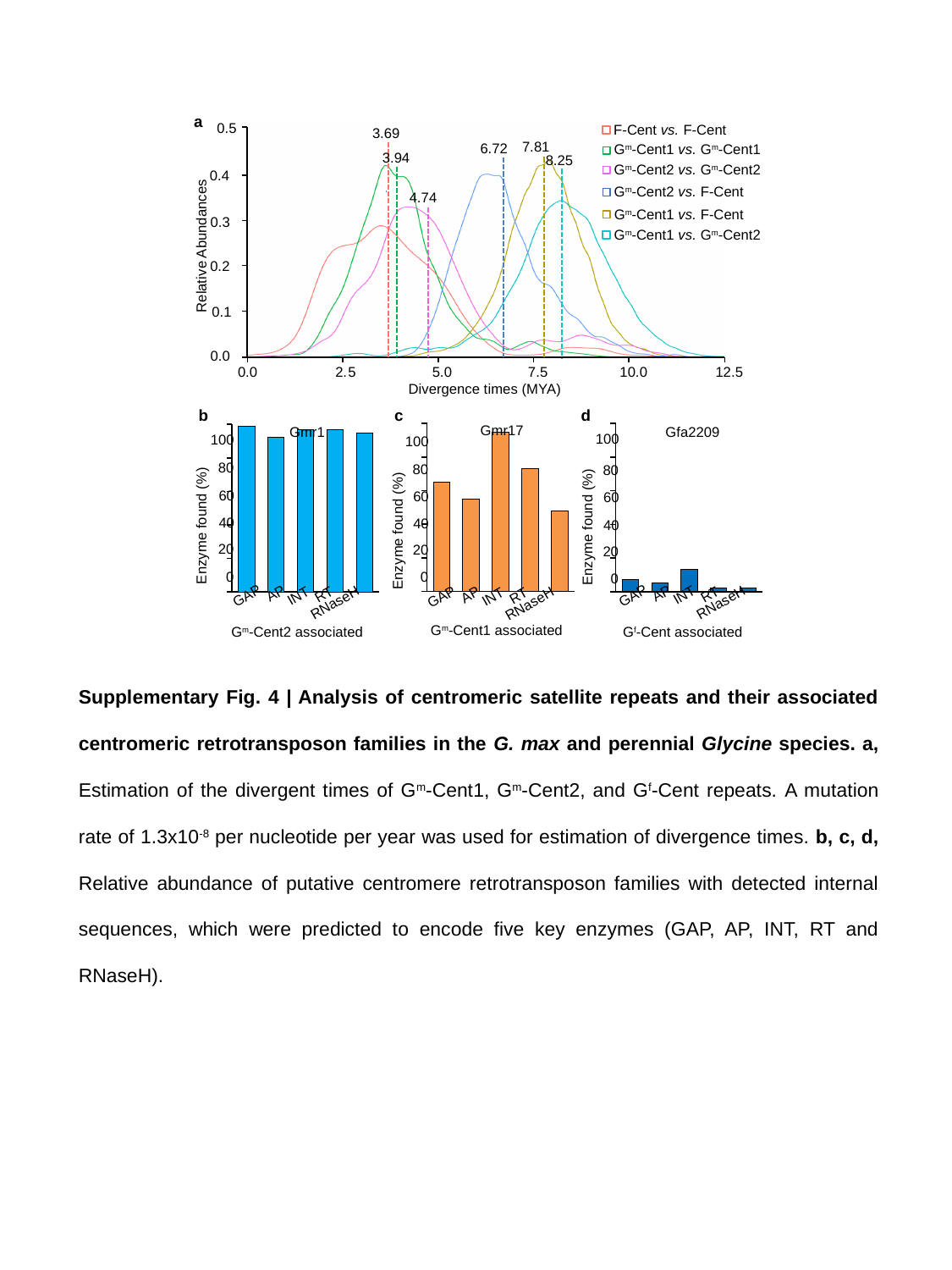
In panel a, what divergence time is labelled on the dashed line for the Gm-Cent1 vs. Gm-Cent2 comparison (the rightmost dashed line)? 8.25 In panel a, what is the smallest divergence time labelled on a dashed line? 3.69 In panel a, how many series does the legend list? 6 In panel c (Gmr17), is the value for GAP greater or less than 60? greater In panel a, what is the x-axis title? Divergence times (MYA) In panel b (Gmr1), is the value for AP greater or less than 80? greater In panel d (Gfa2209), is the value for INT greater or less than 20? less In panel b (Gmr1), how many enzyme categories are shown on the x axis? 5 In panel c (Gmr17), which enzyme has the lowest percentage found? RNaseH In panel a, what kind of chart is shown? line chart In panel c (Gmr17), what kind of chart is shown? bar chart In panel c (Gmr17), which enzyme has the highest percentage found? INT